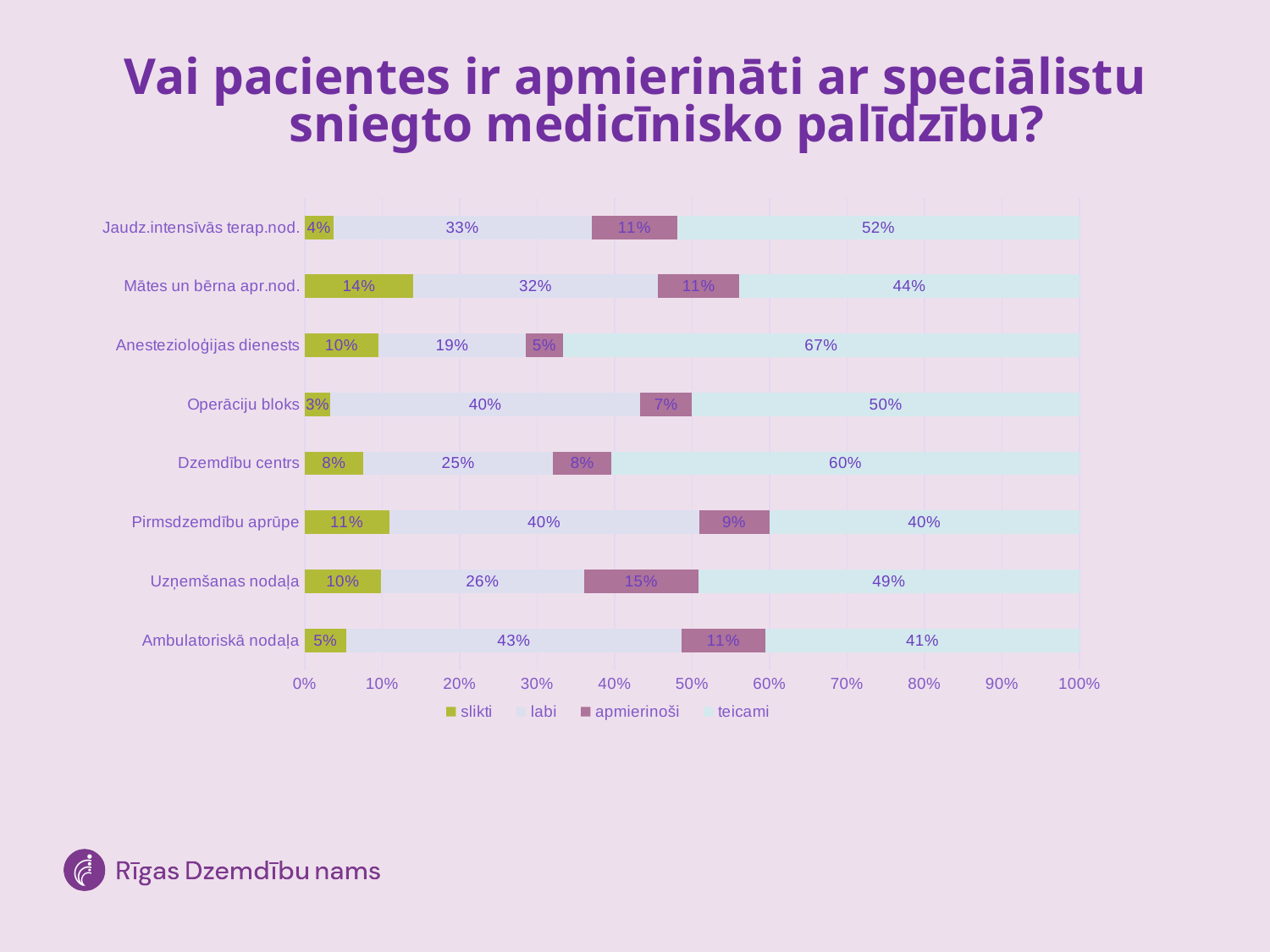
Which has a larger "labi" value: Jaudz.intensīvās terap.nod. or Dzemdību centrs? Jaudz.intensīvās terap.nod. What kind of chart is shown on the slide? Stacked bar chart How many series does the legend list? 4 What is the "labi" value for Ambulatoriskā nodaļa? 43% What is the "apmierinoši" value for Uzņemšanas nodaļa? 15% How many departments are shown on the chart? 8 What percentage of patients rated the Anestezioloģijas dienests as "teicami"? 67% Which department has the lowest "slikti" percentage? Operāciju bloks What is the total of the stacked bar for Operāciju bloks? 100% What is the "slikti" value for Mātes un bērna apr.nod.? 14% What is the difference between the "teicami" values for Dzemdību centrs and Pirmsdzemdību aprūpe? 20% Which department has the highest "teicami" percentage? Anestezioloģijas dienests